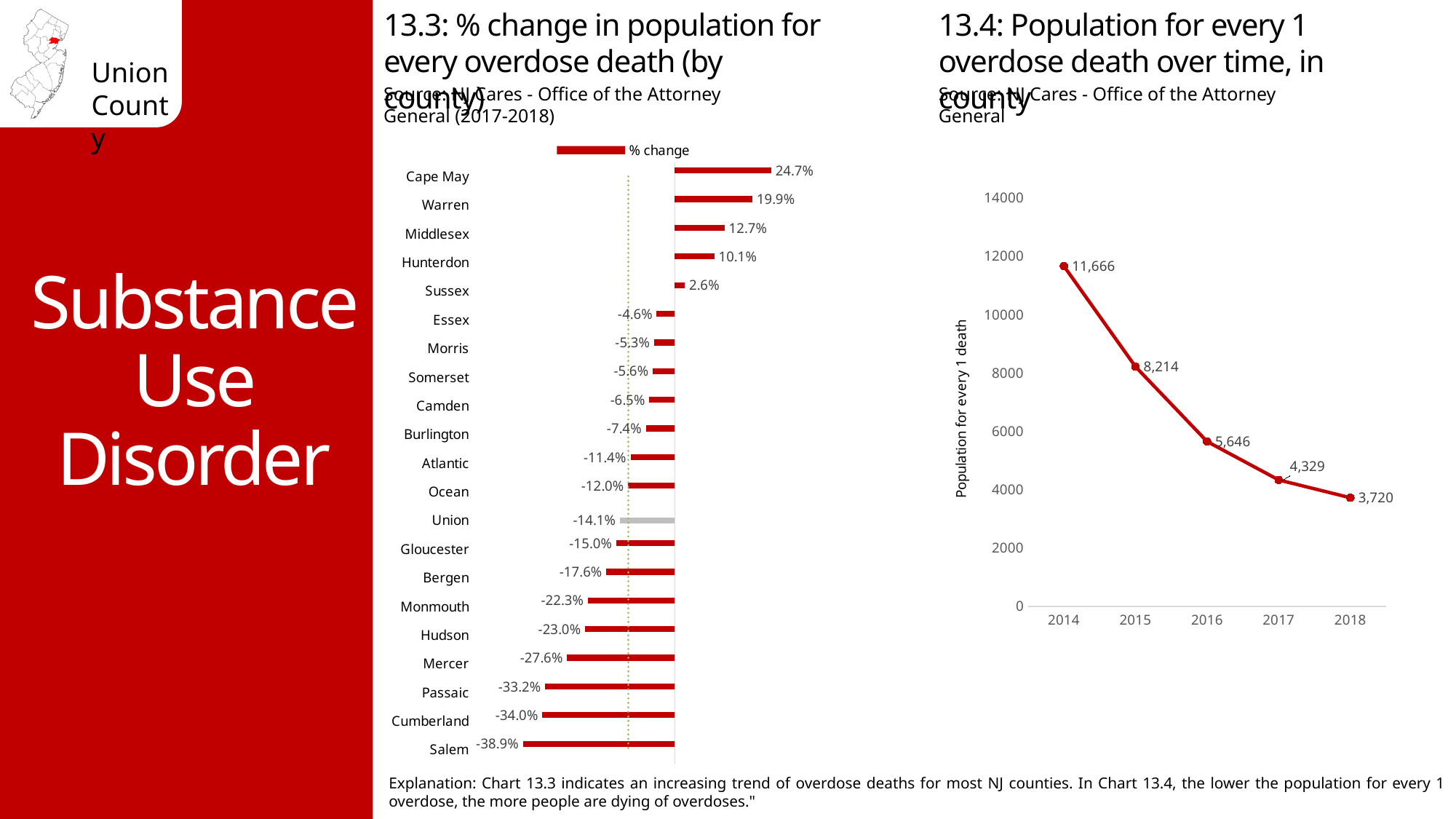
In chart 13.4, what is the population for every 1 overdose death in 2018? 3,720 In chart 13.4, do the values rise or fall from 2014 to 2018? Fall In chart 13.3, what is the difference between the % change for Cape May and Warren? 4.8 percentage points In chart 13.3, which county has the highest % change? Cape May In chart 13.3, what is the % change for Union? -14.1% In chart 13.3, which county has the lowest % change? Salem In chart 13.3, how many counties are shown? 21 In chart 13.4, what is the difference between the 2015 and 2016 values? 2,568 In chart 13.3, which has a larger % change, Warren or Hunterdon? Warren In chart 13.3, what is the % change for Middlesex? 12.7% In chart 13.4, what is the population for every 1 overdose death in 2014? 11,666 What kind of chart is chart 13.3? Bar chart